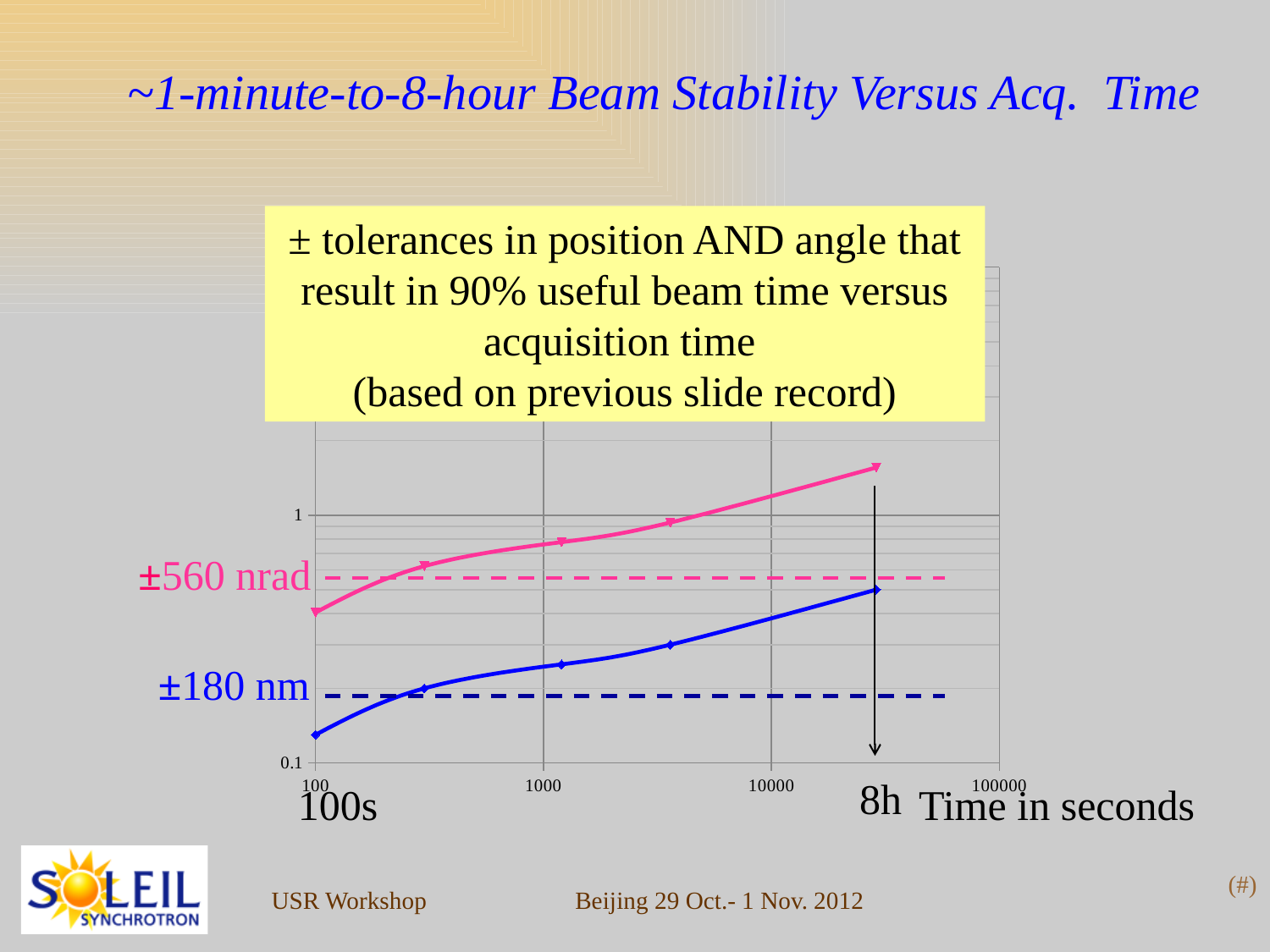
Is the value of the blue line at its last point (8h) greater or less than 1? less What kind of chart is shown on the slide? line chart How many data points are marked on the pink line? 5 Which line has the higher value at 10000 seconds, the pink line or the blue line? pink line How many data points are marked on the blue line? 5 Is the value of the pink line at its last point (8h) greater or less than 1? greater How many data series are plotted on the chart? 2 What value is labelled on the blue dashed horizontal line? ±180 nm Do the values of the blue line rise or fall as time increases along the x axis? rise Do the values of the pink line rise or fall as time increases along the x axis? rise Is the value of the pink line at 100 seconds greater or less than 1? less What is the label of the x axis? Time in seconds